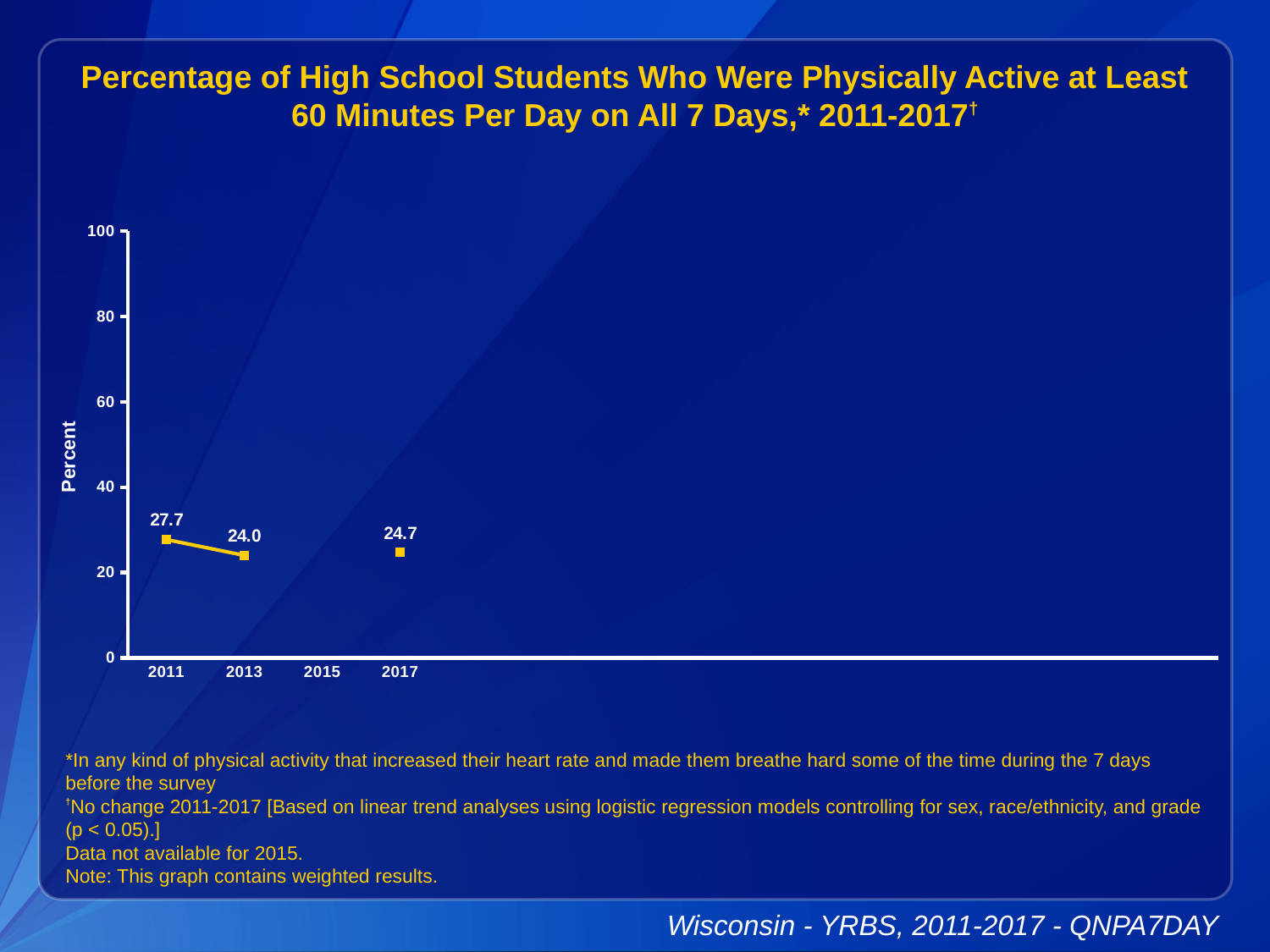
What is the label on the y axis? Percent What kind of chart is shown on the slide? line chart Which year had a higher percentage, 2011 or 2017? 2011 Is the value for 2011 greater or less than 40? less What was the percentage in 2013? 24.0 How many years have data points plotted on the chart? 3 What was the percentage of high school students who were physically active at least 60 minutes per day on all 7 days in 2011? 27.7 Which year had the lowest percentage among the plotted values? 2013 What was the percentage in 2017? 24.7 Which year had the highest percentage? 2011 What is the difference between the 2017 and 2013 values? 0.7 What is the difference between the 2011 and 2013 values? 3.7